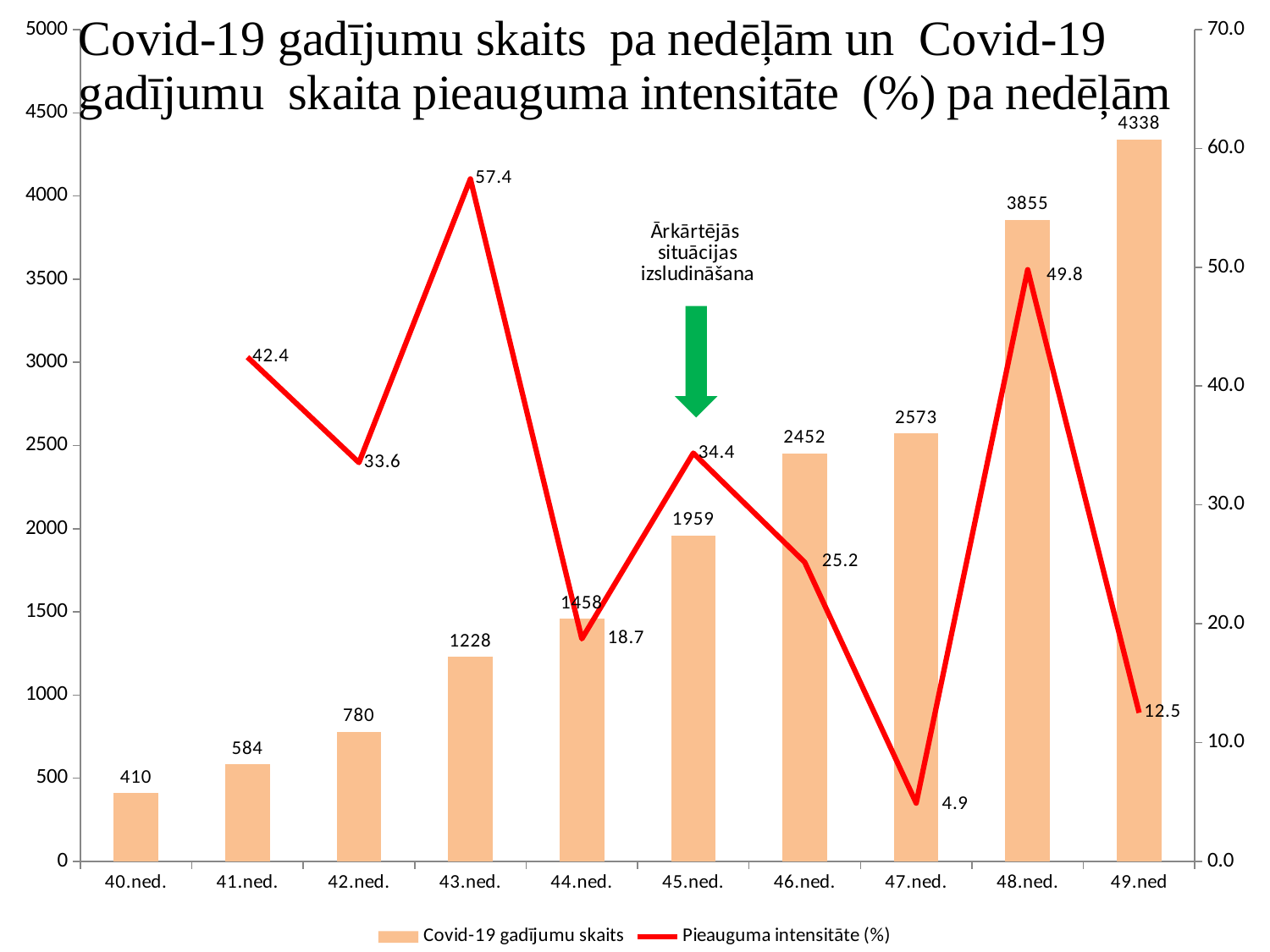
Do the Covid-19 gadījumu skaits values rise or fall from 40.ned. to 49.ned? rise What kind of chart is this? Combined bar and line chart What is the difference in Covid-19 gadījumu skaits between 49.ned and 48.ned.? 483 Which week has the highest Covid-19 gadījumu skaits? 49.ned What is the Covid-19 gadījumu skaits value for 45.ned.? 1959 How many weeks are shown on the x axis? 10 Which is larger, the Pieauguma intensitāte (%) for 41.ned. or for 42.ned.? 41.ned. How many series does the legend list? 2 What is the Pieauguma intensitāte (%) value for 43.ned.? 57.4 What does the green arrow annotation on the chart say? Ārkārtējās situācijas izsludināšana Is the Covid-19 gadījumu skaits for 47.ned. greater or less than 2500? greater Which week has the lowest Pieauguma intensitāte (%)? 47.ned.